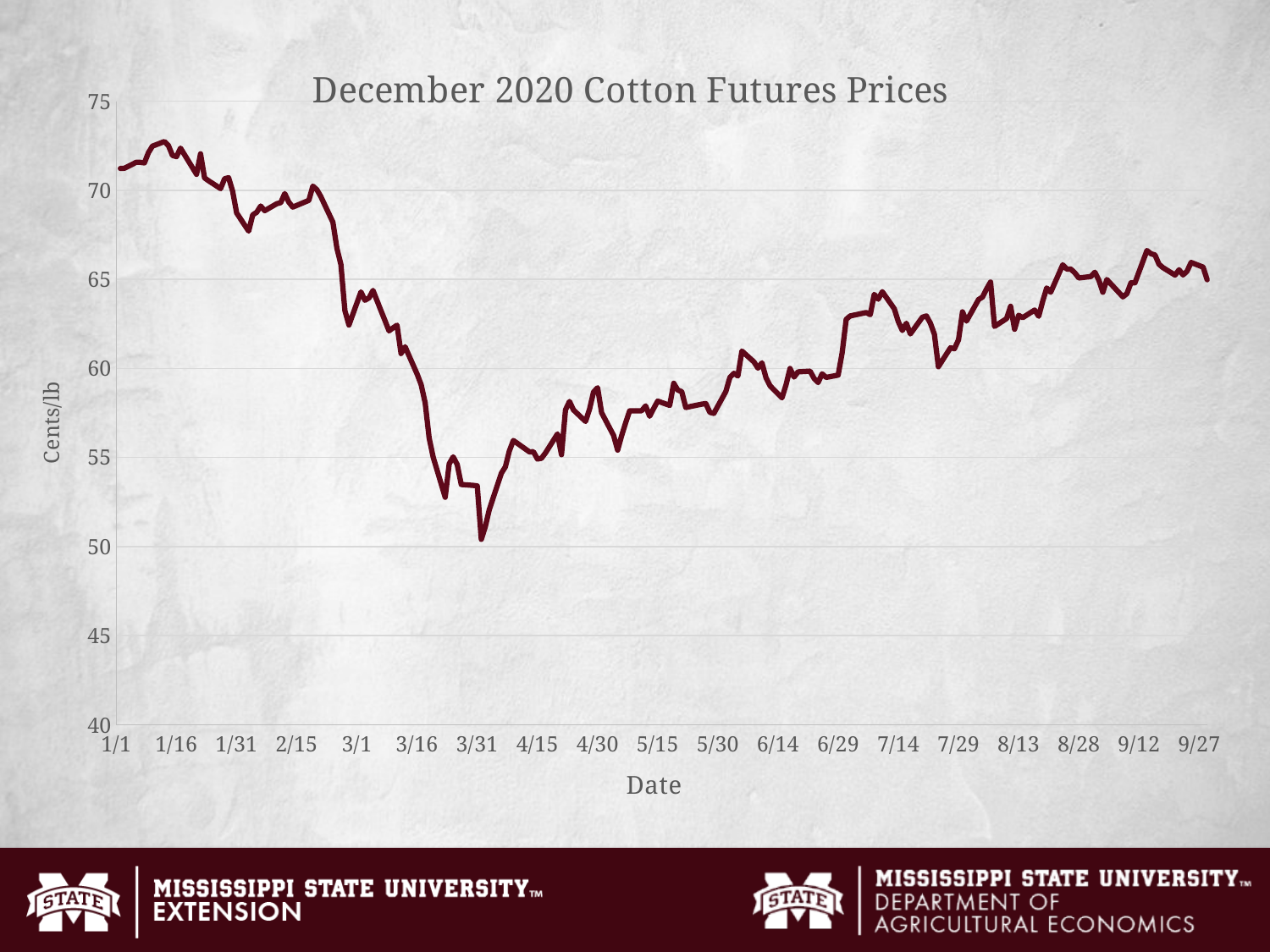
What kind of chart is shown on the slide? Line chart Is the value at 8/13 greater or less than 60? greater What unit is shown on the vertical axis of the chart? Cents/lb Is the value at 5/15 greater or less than 60? less Do prices rise or fall between 1/1 and 3/31? Fall Is the value at 9/27 greater or less than 60? greater Which is higher, the price at 1/1 or the price at 9/27? 1/1 Around which date label does the price reach its lowest point? 3/31 What is the title of the chart? December 2020 Cotton Futures Prices Do prices rise or fall between 3/31 and 9/27? Rise